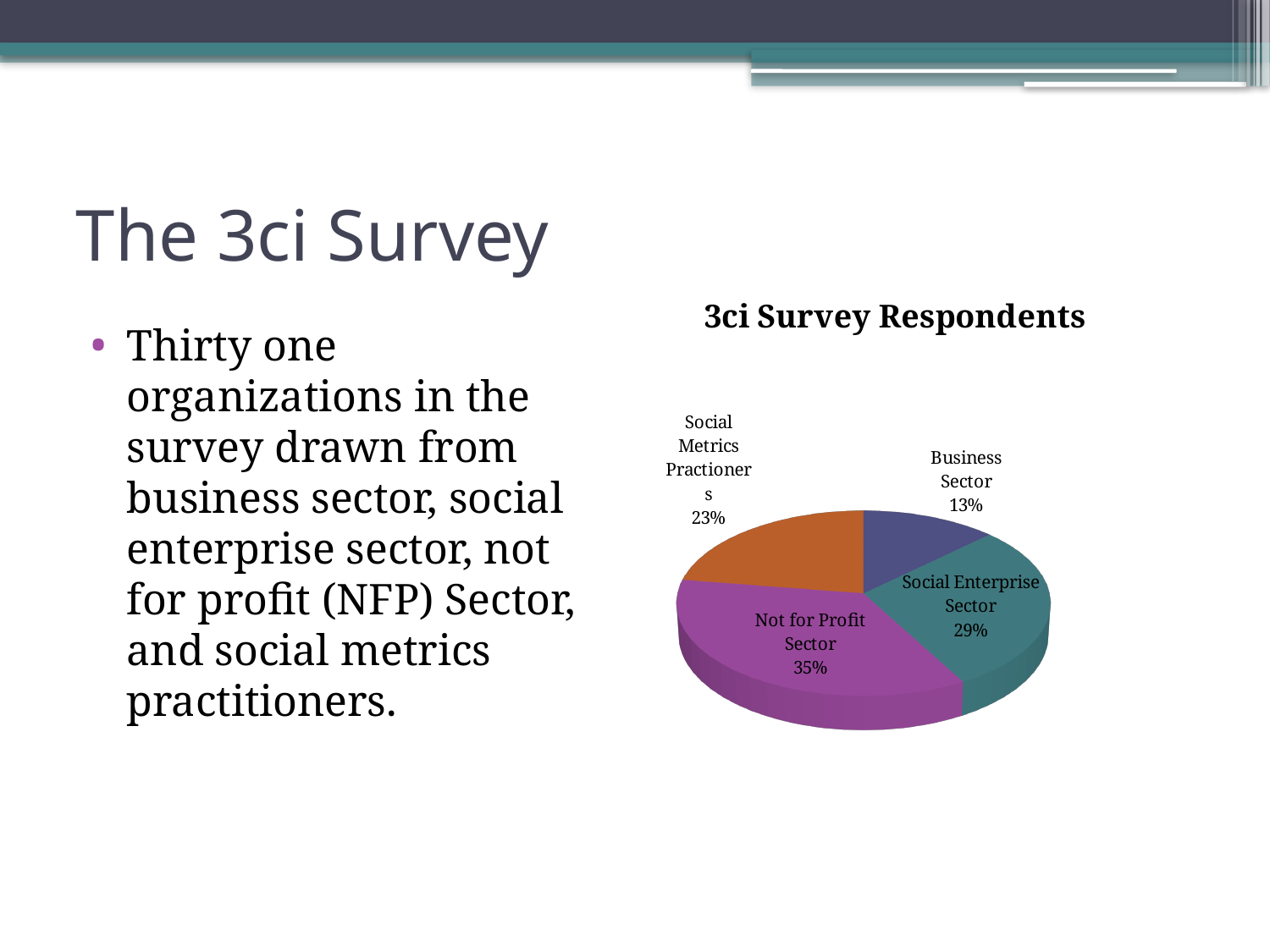
What is the title of the chart? 3ci Survey Respondents Which category has the largest share of respondents? Not for Profit Sector What is the difference in percentage points between the Not for Profit Sector and the Business Sector? 22 What kind of chart is shown on the slide? Pie chart What share of respondents are Social Metrics Practioners? 23% Which category has the smallest share of respondents? Business Sector What share of respondents is from the Social Enterprise Sector? 29% Which is larger, the Social Enterprise Sector share or the Social Metrics Practioners share? Social Enterprise Sector What colour is the Not for Profit Sector slice? Purple How many slices does the pie chart have? 4 What share of respondents is from the Business Sector? 13%